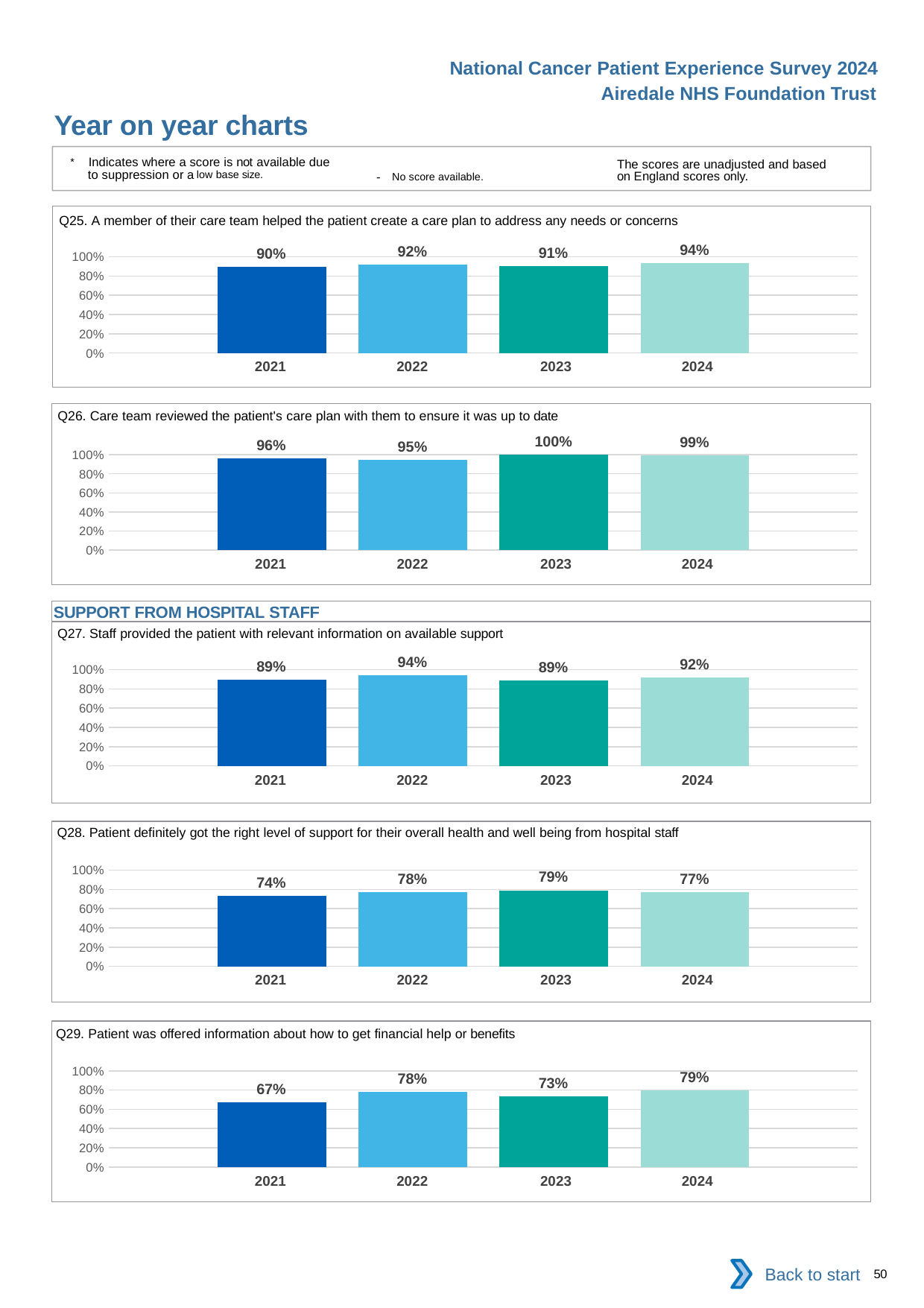
In the Q28 chart, which year has the lowest value? 2021 In the Q27 chart, what is the difference between the 2022 value and the 2023 value? 5% In the Q29 chart, is the value for 2021 greater or less than 80%? less In the Q26 chart, which year has the highest value? 2023 How many years are shown on the x axis of the Q25 chart? 4 In the Q25 chart, what is the value for 2024? 94% What kind of chart is used for Q27? Bar chart In the Q28 chart, what is the value for 2023? 79% In the Q29 chart, which is larger, the value for 2022 or the value for 2023? 2022 In the Q29 chart, what is the value for 2021? 67% In the Q29 chart, what is the difference between the 2024 value and the 2021 value? 12% In the Q26 chart, what is the value for 2022? 95%